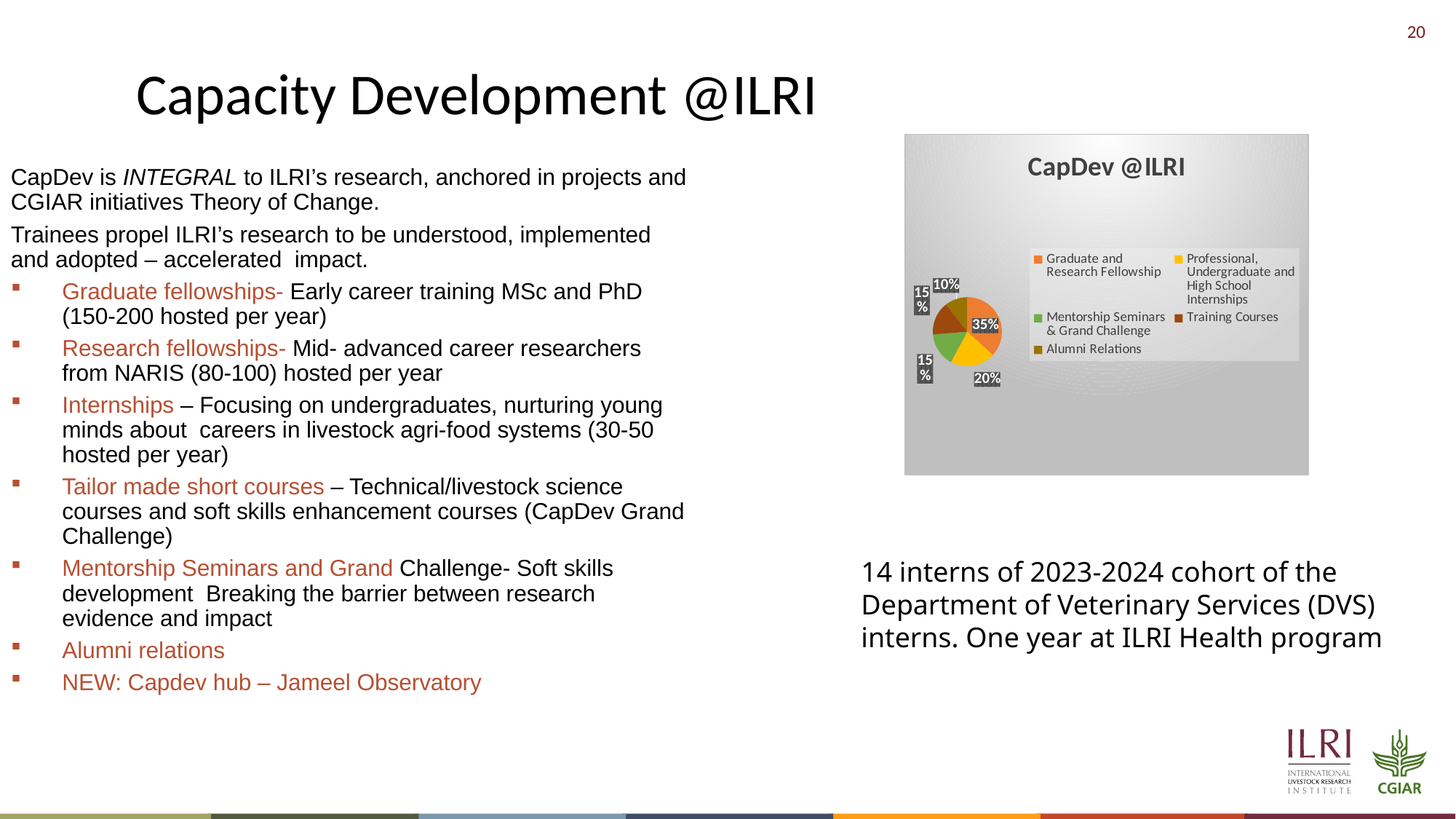
What is the title of the chart on the slide? CapDev @ILRI What share of the pie does Mentorship Seminars & Grand Challenge represent? 15% What share of the pie does Graduate and Research Fellowship represent? 35% What share of the pie does Professional, Undergraduate and High School Internships represent? 20% What colour is the slice for Graduate and Research Fellowship? orange Which category has the largest slice of the pie? Graduate and Research Fellowship How many categories does the legend of the pie chart list? 5 What is the difference in percentage points between Graduate and Research Fellowship and Professional, Undergraduate and High School Internships? 15 Which is larger: the slice for Training Courses or the slice for Alumni Relations? Training Courses What type of chart is shown on the slide? pie chart Which category has the smallest slice of the pie? Alumni Relations